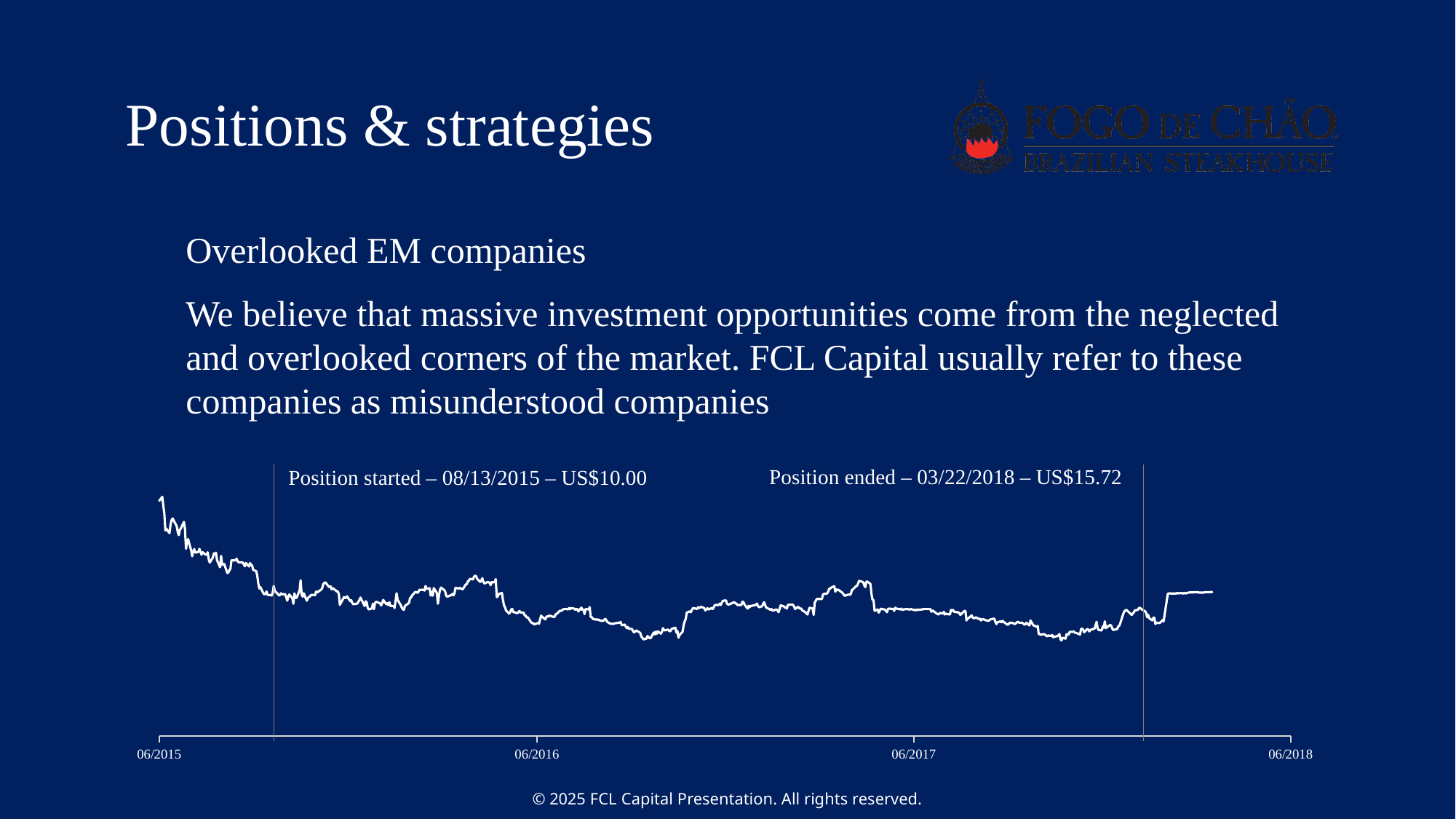
On what date did the position start, according to the chart annotation? 08/13/2015 Which is larger, the price at which the position started or the price at which it ended? the price at which it ended On what date did the position end, according to the chart annotation? 03/22/2018 What colour is the plotted line on the chart? white How many vertical marker lines are drawn on the chart to mark the position start and end? 2 At what price did the position start, according to the chart annotation? US$10.00 What is the last date label on the x axis of the chart? 06/2018 How many date labels are shown on the x axis of the chart? 4 At what price did the position end, according to the chart annotation? US$15.72 What is the first date label on the x axis of the chart? 06/2015 What kind of chart is shown on the slide? line chart What is the difference between the position's ending price and its starting price? US$5.72